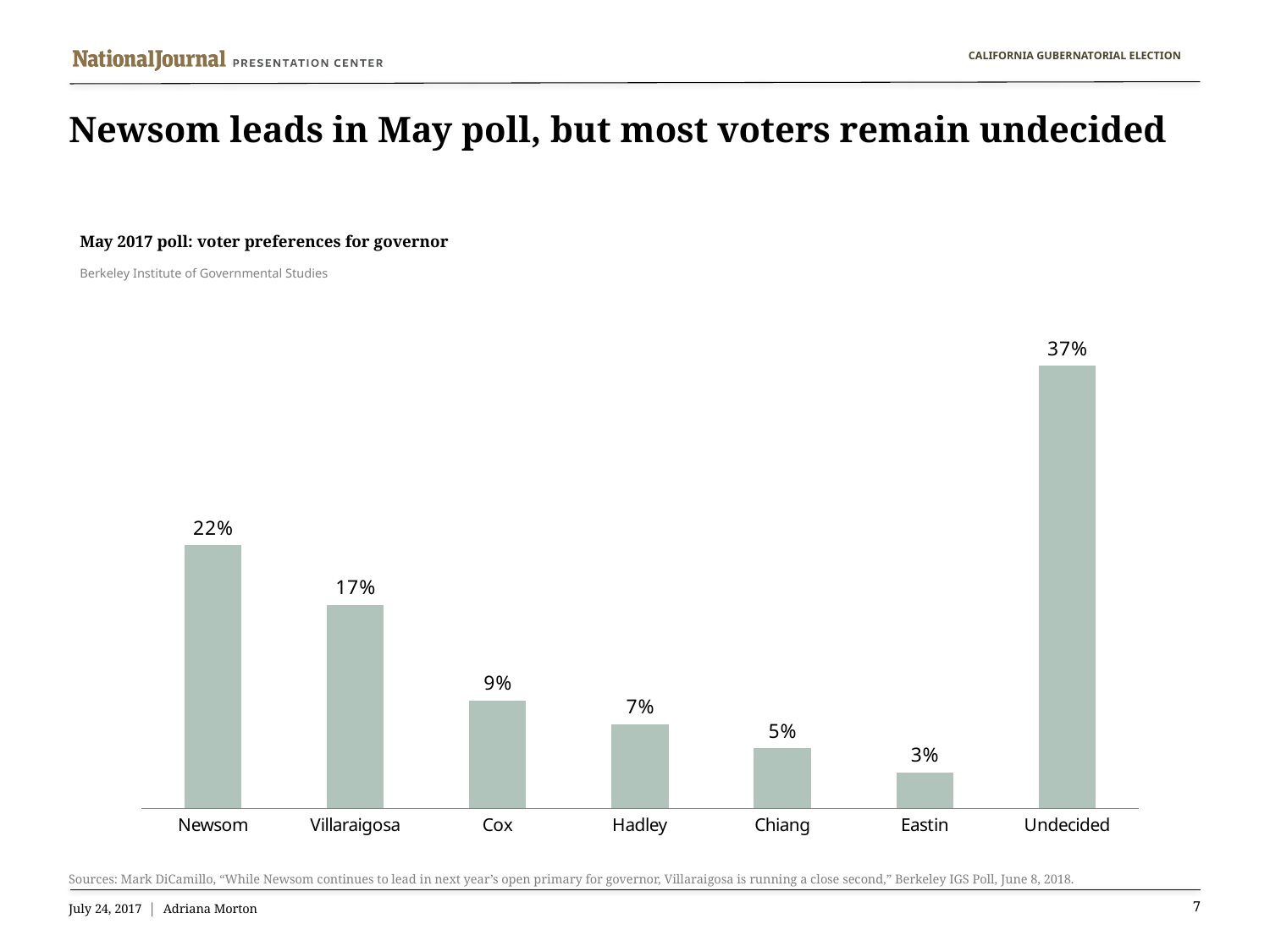
Who has a higher percentage, Cox or Hadley? Cox What percentage of voters were Undecided? 37% Which category has the highest value in the chart? Undecided What is the title of the chart? May 2017 poll: voter preferences for governor What is the value shown for Villaraigosa? 17% What is the difference between Newsom's and Villaraigosa's percentages? 5% How many categories are shown on the x axis of the chart? 7 Which candidate has the lowest share of voter preference? Eastin What is the value shown for Eastin? 3% What percentage of voters preferred Newsom in the May 2017 poll? 22% What type of chart is shown on the slide? Bar chart How much higher is the Undecided share than Newsom's share? 15%